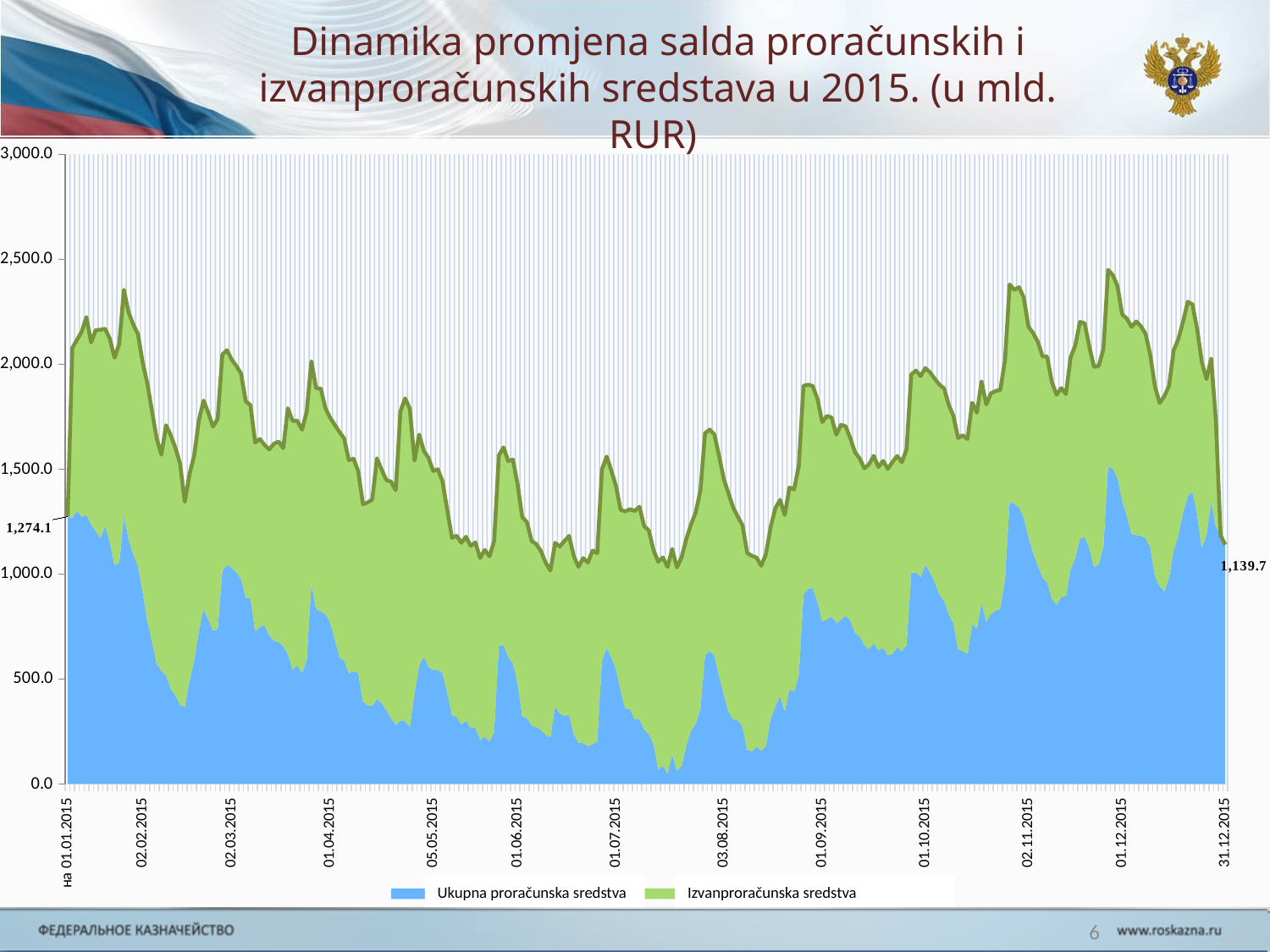
Is the value of Ukupna proračunska sredstva around 03.08.2015 greater or less than 500.0? less How many series does the legend list? 2 What value is labelled at the left edge of the chart, at на 01.01.2015? 1,274.1 How many date labels are shown along the x axis? 13 What kind of chart is shown on the slide? Area chart Which series is shown in green in the legend? Izvanproračunska sredstva Which series is shown in blue in the legend? Ukupna proračunska sredstva Is the combined total of both series at 01.12.2015 greater or less than 2,000.0? greater What is the difference between the value labelled at 01.01.2015 (1,274.1) and the value labelled at 31.12.2015 (1,139.7)? 134.4 What value is labelled at the right edge of the chart, at 31.12.2015? 1,139.7 Does the combined total of both series rise or fall between 03.08.2015 and 01.12.2015? rise Is the combined total of both series at 01.07.2015 greater or less than 2,000.0? less